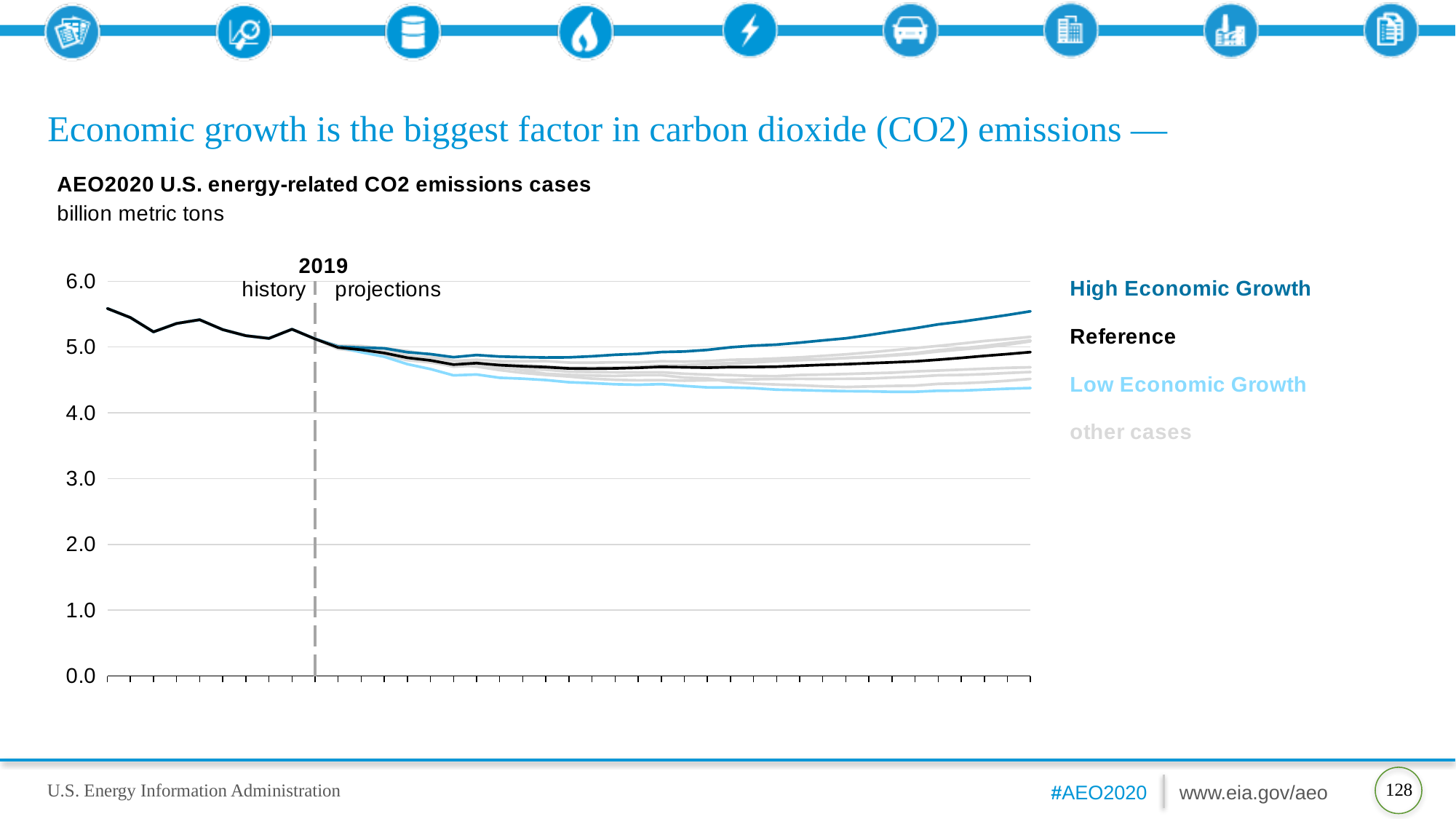
At the end of the projection period, is the value for High Economic Growth greater or less than 5.0? greater How many entries does the legend list? 4 At the end of the projection period, is the value for Low Economic Growth greater or less than 4.0? greater At the end of the projection period, which is larger: the High Economic Growth case or the Reference case? High Economic Growth Which case has the highest emissions at the end of the projection period? High Economic Growth What is the title of the chart? AEO2020 U.S. energy-related CO2 emissions cases What kind of chart is shown on the slide? line chart Which case has the lowest emissions at the end of the projection period? Low Economic Growth What unit is the chart's y axis measured in? billion metric tons Over the projection period, does the High Economic Growth line rise or fall overall? rise Over the projection period, does the Low Economic Growth line rise or fall overall? fall At the end of the projection period, is the value for Low Economic Growth greater or less than 5.0? less